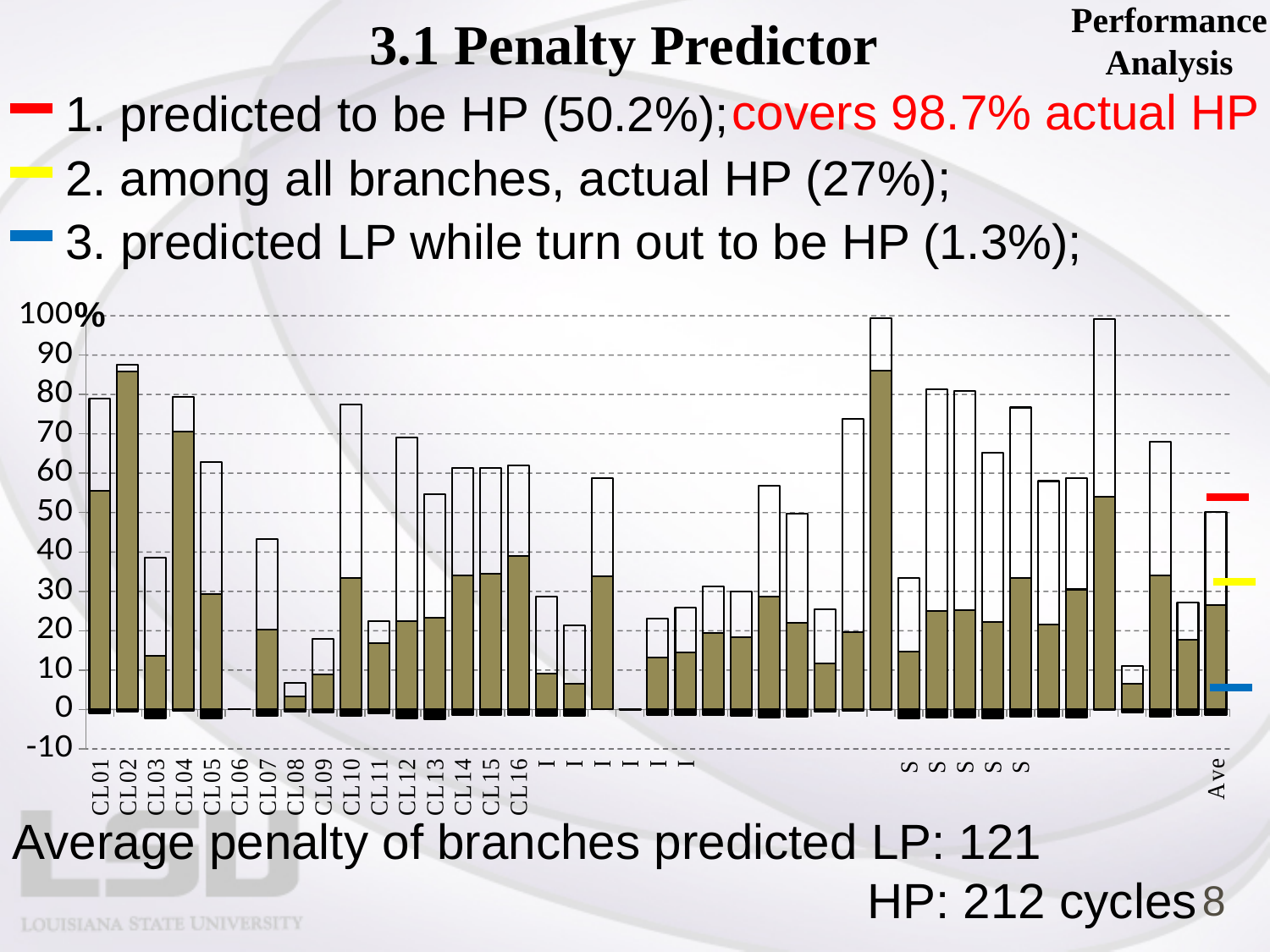
Which has the taller total bar, CL04 or CL05? CL04 How many categories labelled CL01 through CL16 are on the x axis? 16 Which has the taller total bar, CL02 or CL03? CL02 Among the categories CL01 to CL16, which has the tallest total bar? CL02 Which has the taller total bar, CL07 or CL08? CL07 What kind of chart is shown on the slide? stacked bar chart Is the total bar height for Ave greater or less than 40? greater Is the total bar height for CL02 greater or less than 80? greater Is the total bar height for CL10 greater or less than 70? greater What is the highest tick label shown on the y axis? 100%